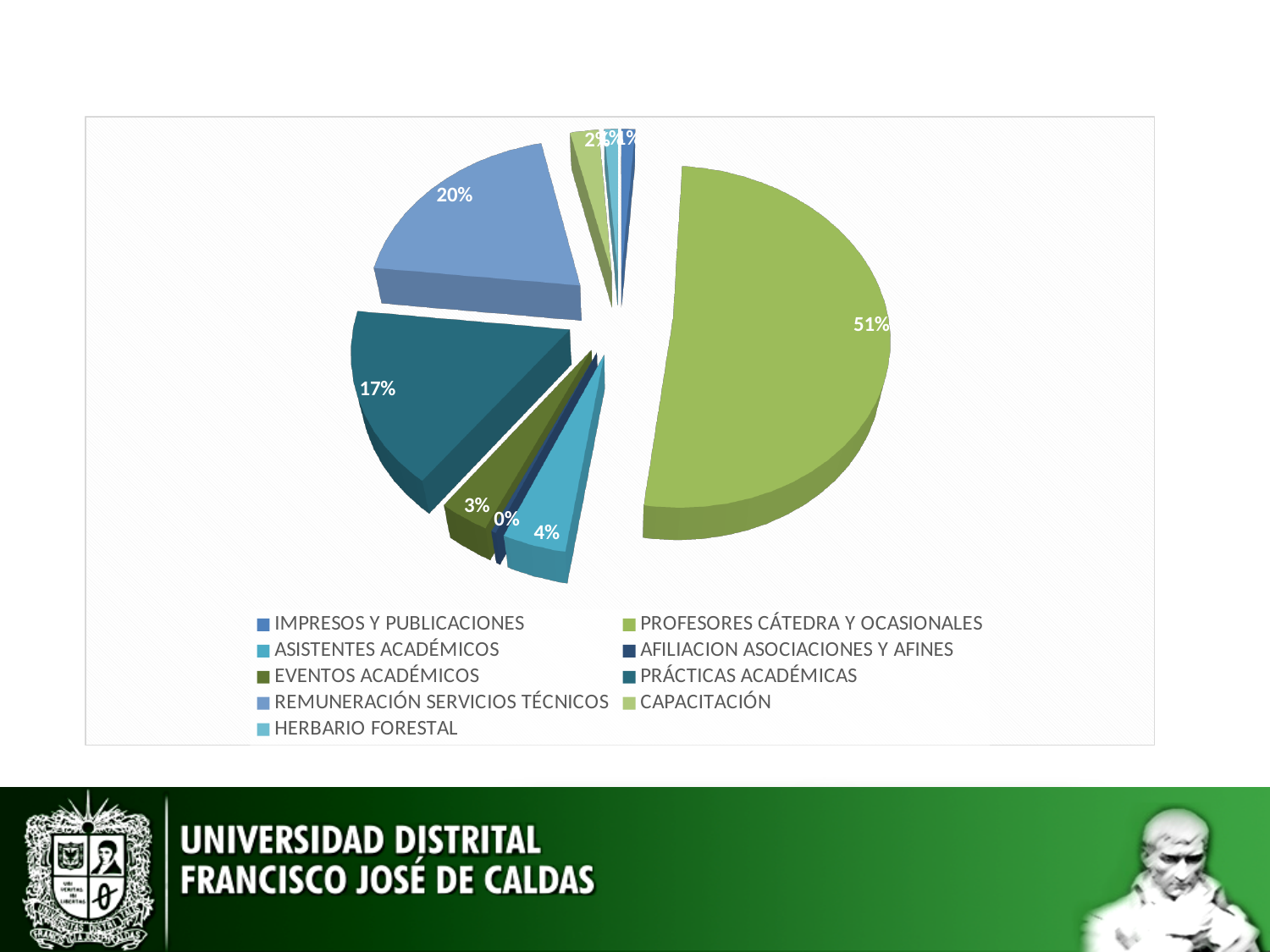
Which is larger, the share for REMUNERACIÓN SERVICIOS TÉCNICOS or the share for PRÁCTICAS ACADÉMICAS? REMUNERACIÓN SERVICIOS TÉCNICOS What percentage is shown for AFILIACION ASOCIACIONES Y AFINES? 0% Which category has the largest slice of the pie? PROFESORES CÁTEDRA Y OCASIONALES Which category has the smallest slice of the pie? AFILIACION ASOCIACIONES Y AFINES What percentage is shown for EVENTOS ACADÉMICOS? 3% What percentage is shown for REMUNERACIÓN SERVICIOS TÉCNICOS? 20% What percentage is shown for ASISTENTES ACADÉMICOS? 4% What is the difference in percentage points between PROFESORES CÁTEDRA Y OCASIONALES and REMUNERACIÓN SERVICIOS TÉCNICOS? 31 What kind of chart is shown on the slide? Pie chart What share of the pie does PROFESORES CÁTEDRA Y OCASIONALES represent? 51% How many categories does the legend list? 9 What percentage is shown for PRÁCTICAS ACADÉMICAS? 17%